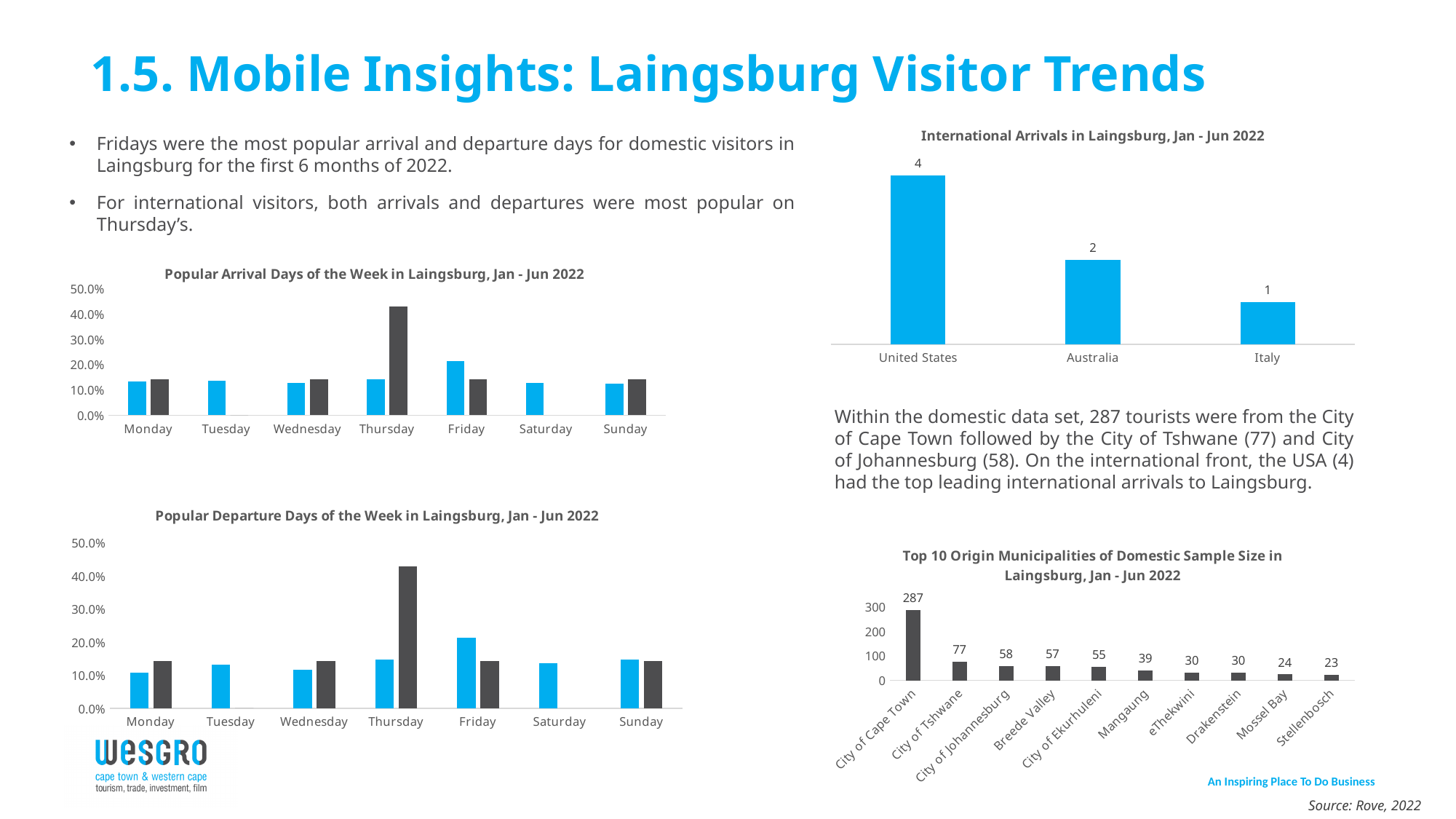
In the 'International Arrivals in Laingsburg, Jan - Jun 2022' chart, what is the difference between the arrivals from the United States and Australia? 2 How many days of the week are shown on the x axis of the 'Popular Departure Days of the Week in Laingsburg, Jan - Jun 2022' chart? 7 What kind of chart is 'Popular Arrival Days of the Week in Laingsburg, Jan - Jun 2022'? Bar chart In the 'Top 10 Origin Municipalities of Domestic Sample Size' chart, which municipality has the highest value? City of Cape Town In the 'Top 10 Origin Municipalities of Domestic Sample Size' chart, what is the value for Stellenbosch? 23 In the 'Top 10 Origin Municipalities of Domestic Sample Size' chart, what is the value for City of Tshwane? 77 In the 'Top 10 Origin Municipalities of Domestic Sample Size' chart, which is larger: Mangaung or Mossel Bay? Mangaung In the 'International Arrivals in Laingsburg, Jan - Jun 2022' chart, how many international arrivals came from the United States? 4 In the 'International Arrivals in Laingsburg, Jan - Jun 2022' chart, which country has the lowest number of arrivals? Italy In the 'Top 10 Origin Municipalities of Domestic Sample Size' chart, what is the difference between City of Cape Town and City of Johannesburg? 229 How many countries are shown in the 'International Arrivals in Laingsburg, Jan - Jun 2022' chart? 3 In the 'Popular Arrival Days of the Week in Laingsburg, Jan - Jun 2022' chart, is the value of the dark grey bar for Thursday greater or less than 40.0%? greater